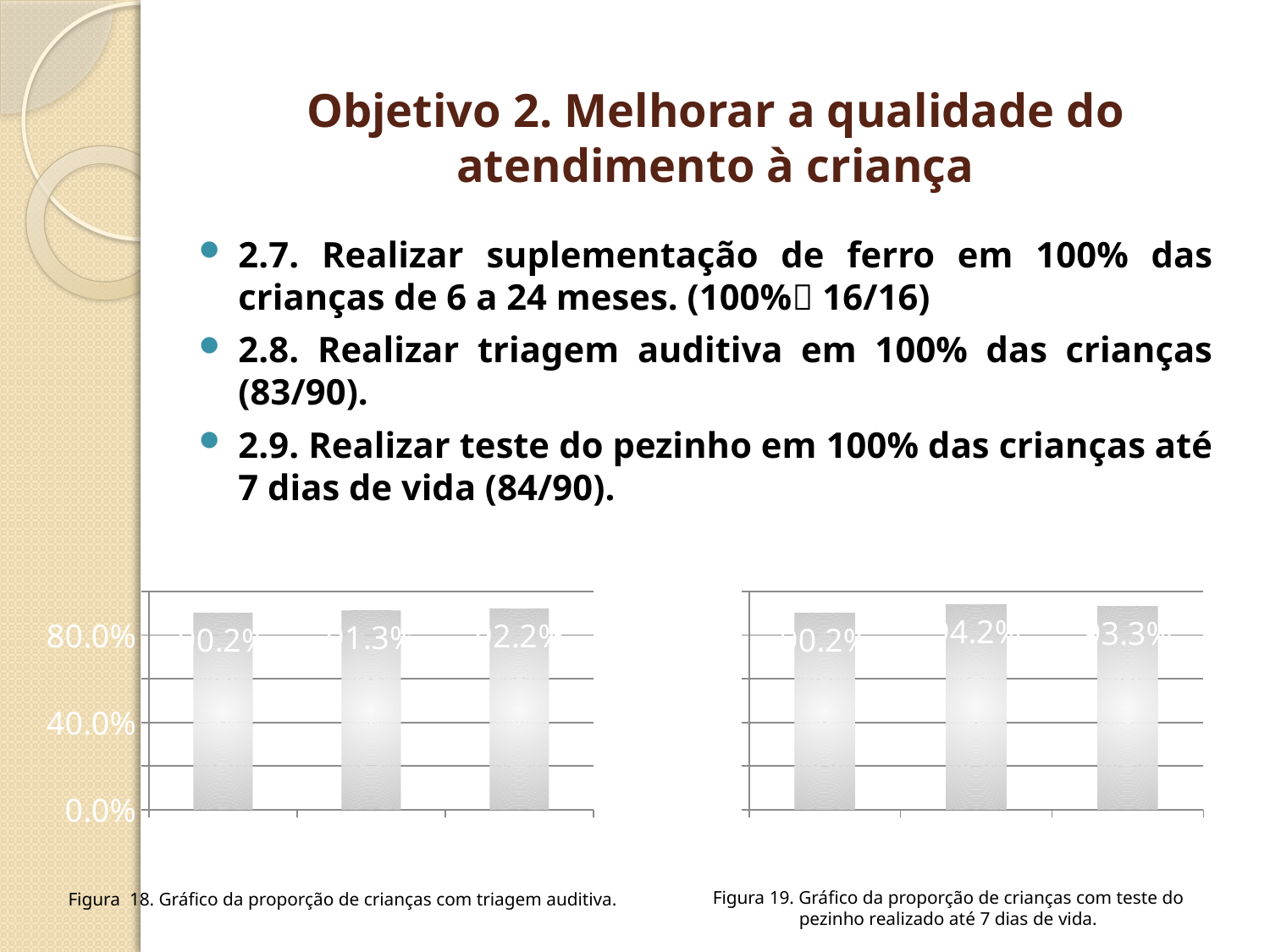
What is the caption of the right chart? Figura 19. Gráfico da proporção de crianças com teste do pezinho realizado até 7 dias de vida. In Figura 18 (the left chart), is the value of the third bar greater or less than 40.0%? greater What kind of chart is Figura 18 (the left chart)? bar chart How many bars are plotted in Figura 19 (the right chart)? 3 What kind of chart is Figura 19 (the right chart)? bar chart In Figura 18 (the left chart), do the bar values rise or fall from left to right? rise In Figura 18 (the left chart), is the value of the first bar greater or less than 80.0%? greater What is the caption of the left chart? Figura 18. Gráfico da proporção de crianças com triagem auditiva. In Figura 19 (the right chart), which bar is the lowest? the first bar In Figura 19 (the right chart), which is larger, the first bar or the second bar? the second bar How many bars are plotted in Figura 18 (the left chart)? 3